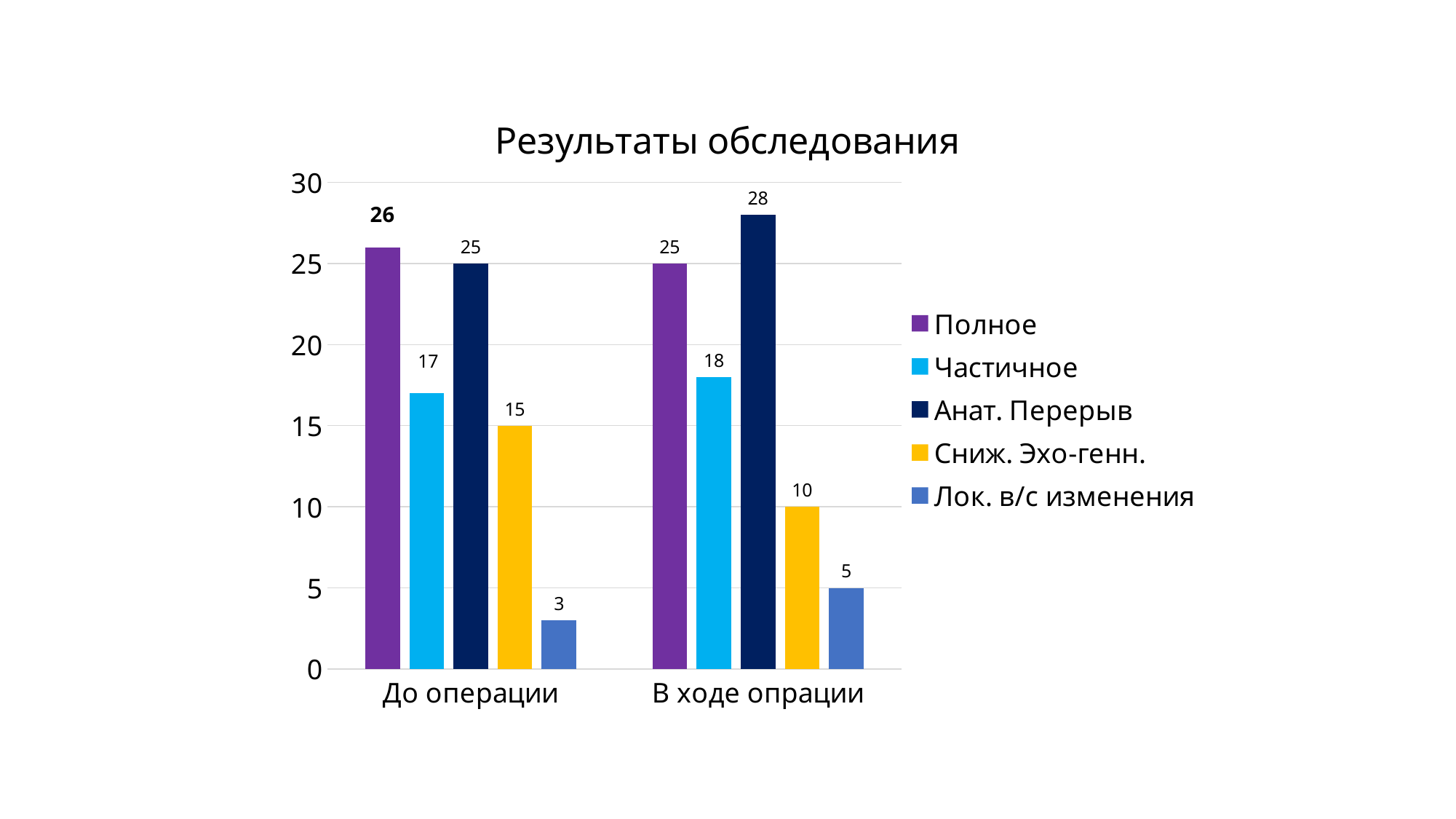
What is the value of Анат. Перерыв for В ходе опрации? 28 What is the value of Лок. в/с изменения for До операции? 3 What is the title of the chart? Результаты обследования What kind of chart is shown? Bar chart Which series has the lowest value for До операции? Лок. в/с изменения What is the difference between Сниж. Эхо-генн. for До операции and for В ходе опрации? 5 How many categories are shown on the x axis? 2 Which series has the highest value for В ходе опрации? Анат. Перерыв What is the value of Сниж. Эхо-генн. for В ходе опрации? 10 Which is larger: Частичное for До операции or Частичное for В ходе опрации? В ходе опрации How many series does the legend list? 5 What is the value of Полное for До операции? 26